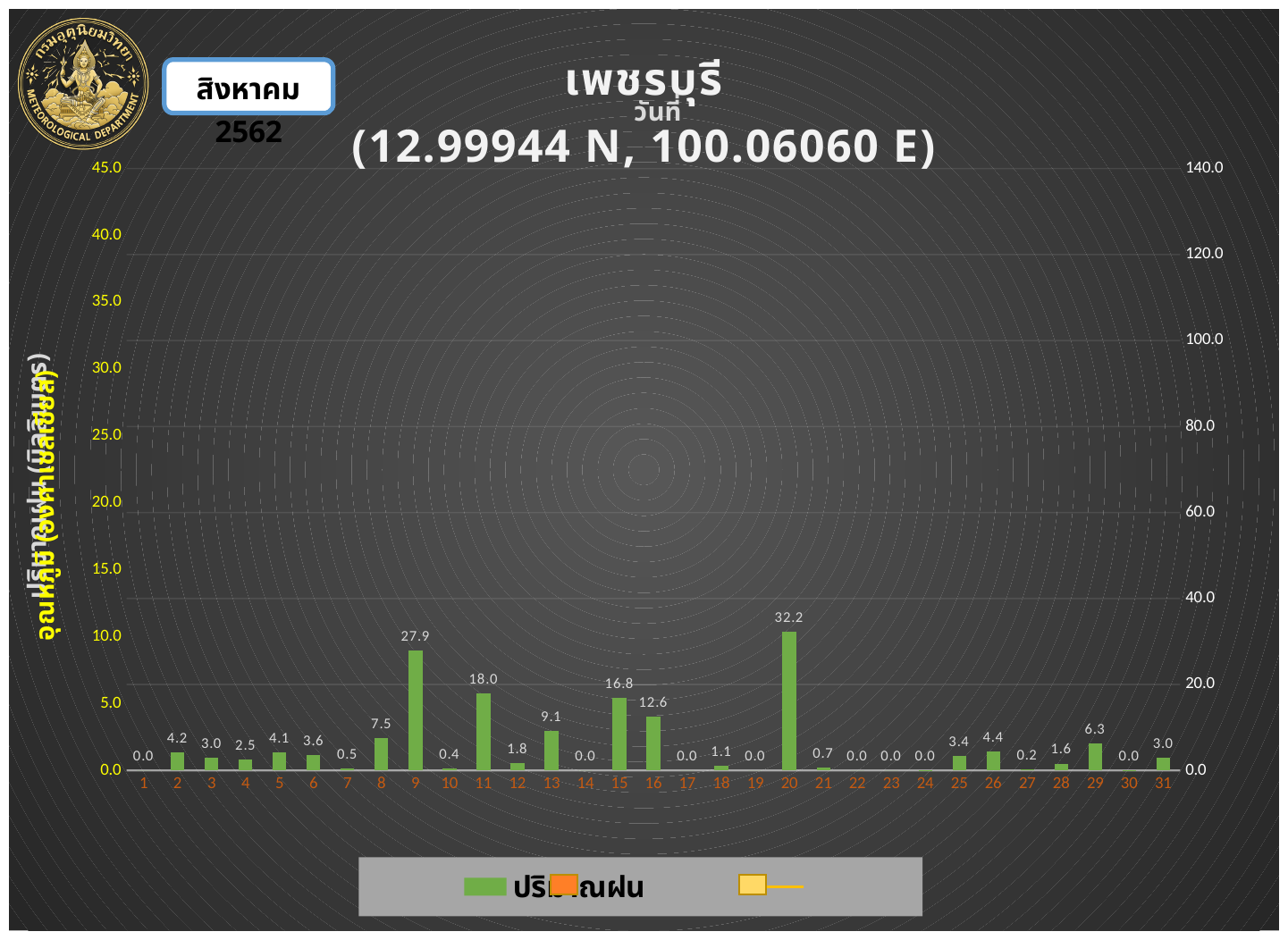
How many days are shown on the x axis? 31 What is the rainfall value shown for day 29? 6.3 What is the difference between the rainfall values for day 20 and day 9? 4.3 What is the difference between the rainfall values for day 15 and day 16? 4.2 What is the title of the chart? เพชรบุรี (12.99944 N, 100.06060 E) What kind of chart is shown on the slide? bar chart What is the rainfall value shown for day 9? 27.9 Which has a larger rainfall value, day 8 or day 26? day 8 Which day has the highest rainfall value? 20 What is the rainfall value shown for day 20? 32.2 What is the rainfall value shown for day 11? 18.0 Which has a larger rainfall value, day 11 or day 13? day 11